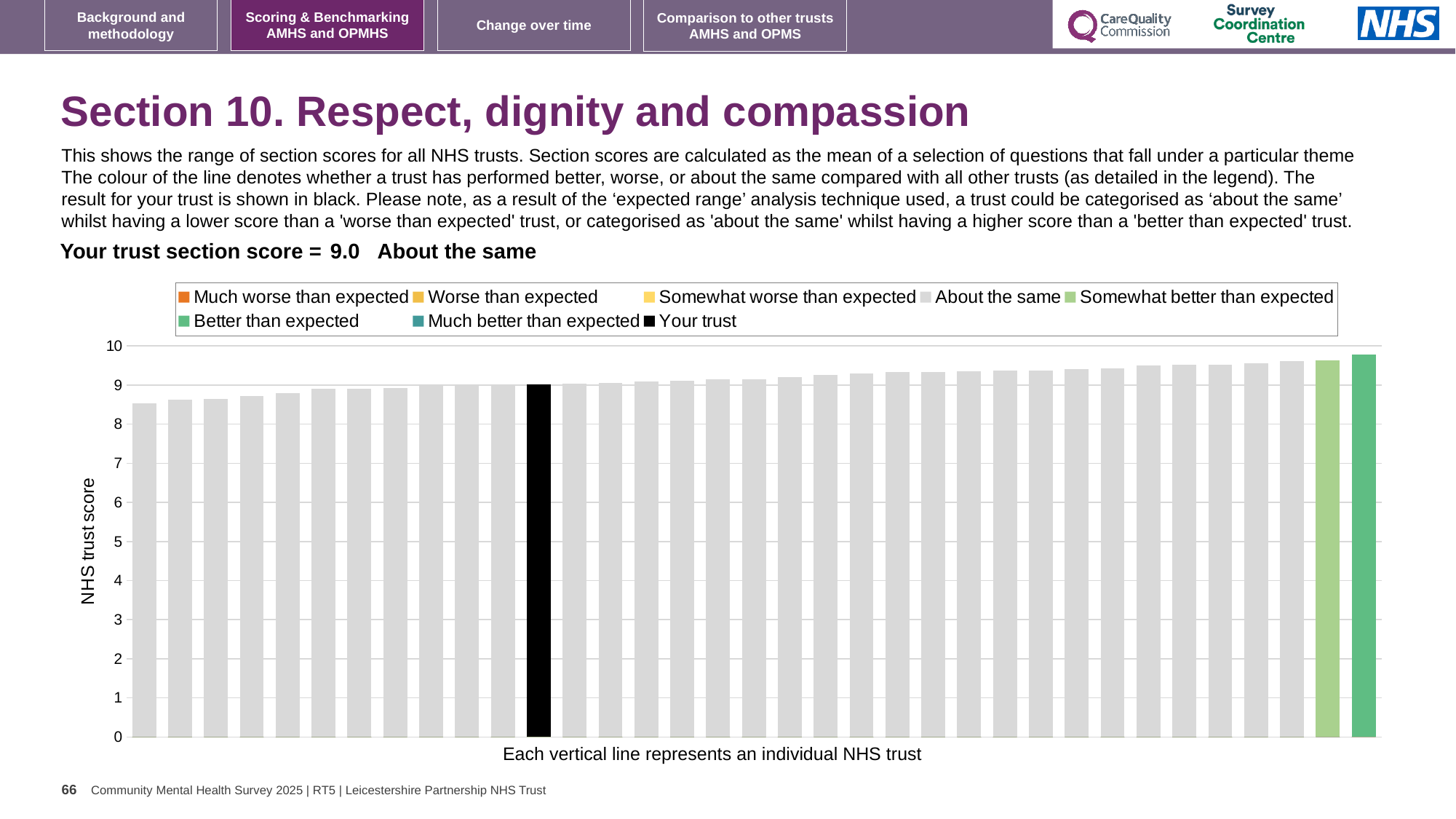
How many entries does the legend list? 8 Is the value of the leftmost bar greater or less than 9? less Is the value of the black 'Your trust' bar greater or less than 8? greater Is the value of the rightmost bar greater or less than 9? greater Which benchmarking category is your trust placed in for this section? About the same How many bars (NHS trusts) are plotted in the chart? 35 Which is larger, the leftmost bar or the rightmost bar? the rightmost bar What is the section score for your trust (the black bar)? 9.0 Do the bar values rise or fall from left to right along the x axis? rise What is the label on the y axis of the chart? NHS trust score What kind of chart is shown on the slide? bar chart